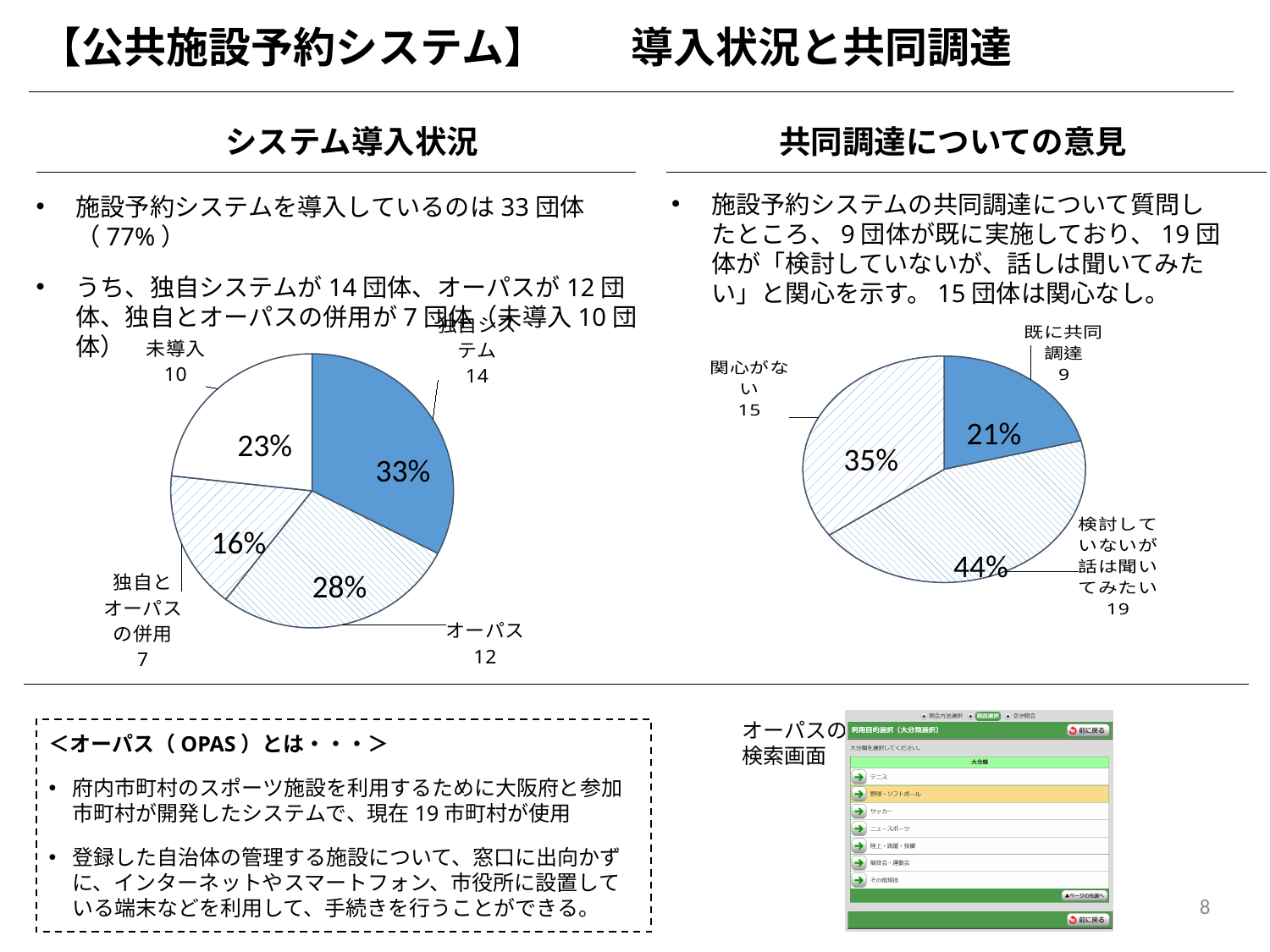
In the left chart (システム導入状況), which category has the largest slice? 独自システム In the left chart (システム導入状況), what is the value for 独自システム? 14 In the right chart (共同調達についての意見), which is larger, 関心がない or 既に共同調達? 関心がない In the left chart (システム導入状況), what is the difference between 未導入 and 独自とオーパスの併用? 3 In the right chart (共同調達についての意見), how many slices does the pie have? 3 In the left chart (システム導入状況), what kind of chart is shown? pie chart In the right chart (共同調達についての意見), what is the value for 関心がない? 15 In the right chart (共同調達についての意見), what share of the pie is 既に共同調達? 21% In the left chart (システム導入状況), what share of the pie is オーパス? 28% In the right chart (共同調達についての意見), which category has the largest slice? 検討していないが話は聞いてみたい In the left chart (システム導入状況), which category has the smallest slice? 独自とオーパスの併用 In the left chart (システム導入状況), how many slices does the pie have? 4